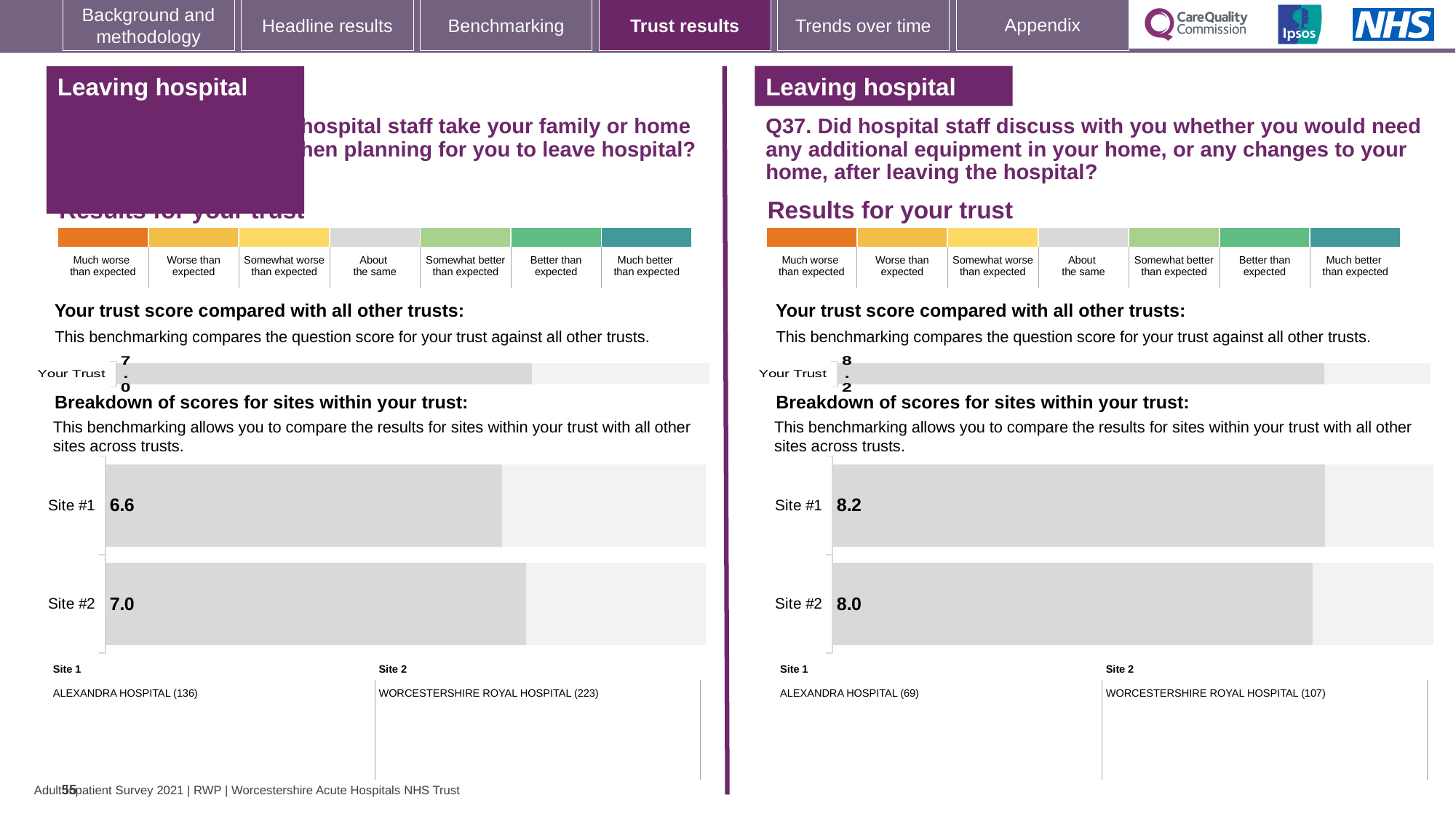
On the left-hand site breakdown chart, what is the score for Site #1? 6.6 On the right-hand chart for Q37, what is the score for Site #1? 8.2 On the left-hand site breakdown chart, which site has the higher score? Site #2 On the right-hand site breakdown chart for Q37, what is the difference between the Site #1 and Site #2 scores? 0.2 On the right-hand 'Your Trust' chart for Q37, what is the trust score shown? 8.2 On the left-hand 'Your Trust' chart, what is the trust score shown? 7.0 On the left-hand site breakdown chart, what is the difference between the Site #2 and Site #1 scores? 0.4 On the right-hand chart for Q37, what is the score for Site #2? 8.0 What type of chart is used for the site breakdown on the left-hand side of the slide? Bar chart How many sites are shown in the right-hand site breakdown chart for Q37? 2 On the right-hand site breakdown chart for Q37, which site has the lower score? Site #2 On the left-hand site breakdown chart, what is the score for Site #2? 7.0